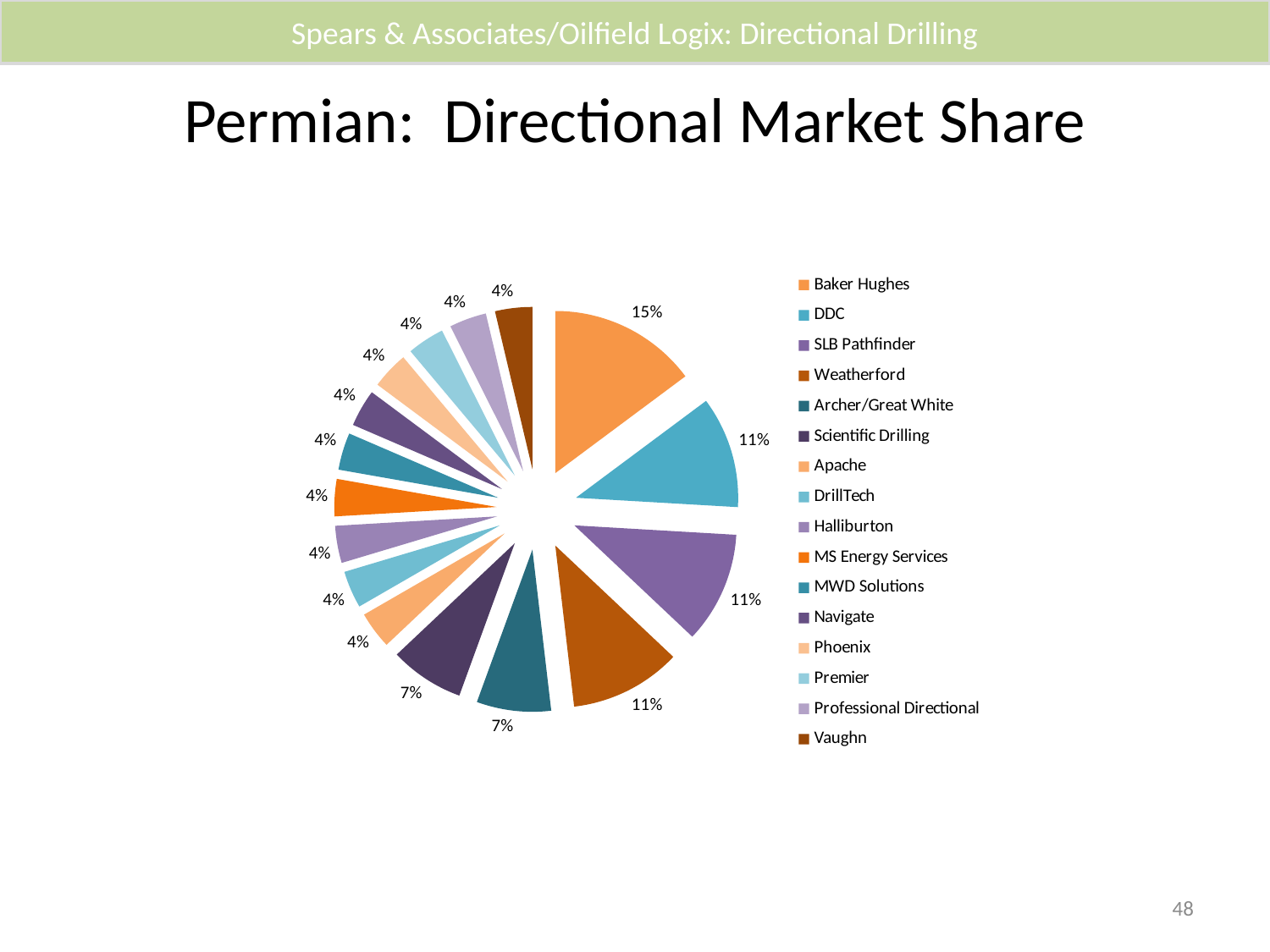
How many companies are listed in the chart's legend? 16 What is DDC's share of the Permian directional market? 11% How many percentage points larger is Baker Hughes' share than SLB Pathfinder's share? 4 Which has the larger share, Archer/Great White or Halliburton? Archer/Great White What is the title of the chart on the slide? Permian: Directional Market Share What is Weatherford's share of the Permian directional market? 11% What is Vaughn's share of the Permian directional market? 4% Which company has the largest share of the Permian directional market? Baker Hughes What is Baker Hughes' share of the Permian directional market? 15% What kind of chart is shown on the slide? Pie chart What is Scientific Drilling's share of the Permian directional market? 7% How many percentage points larger is DDC's share than Archer/Great White's share? 4